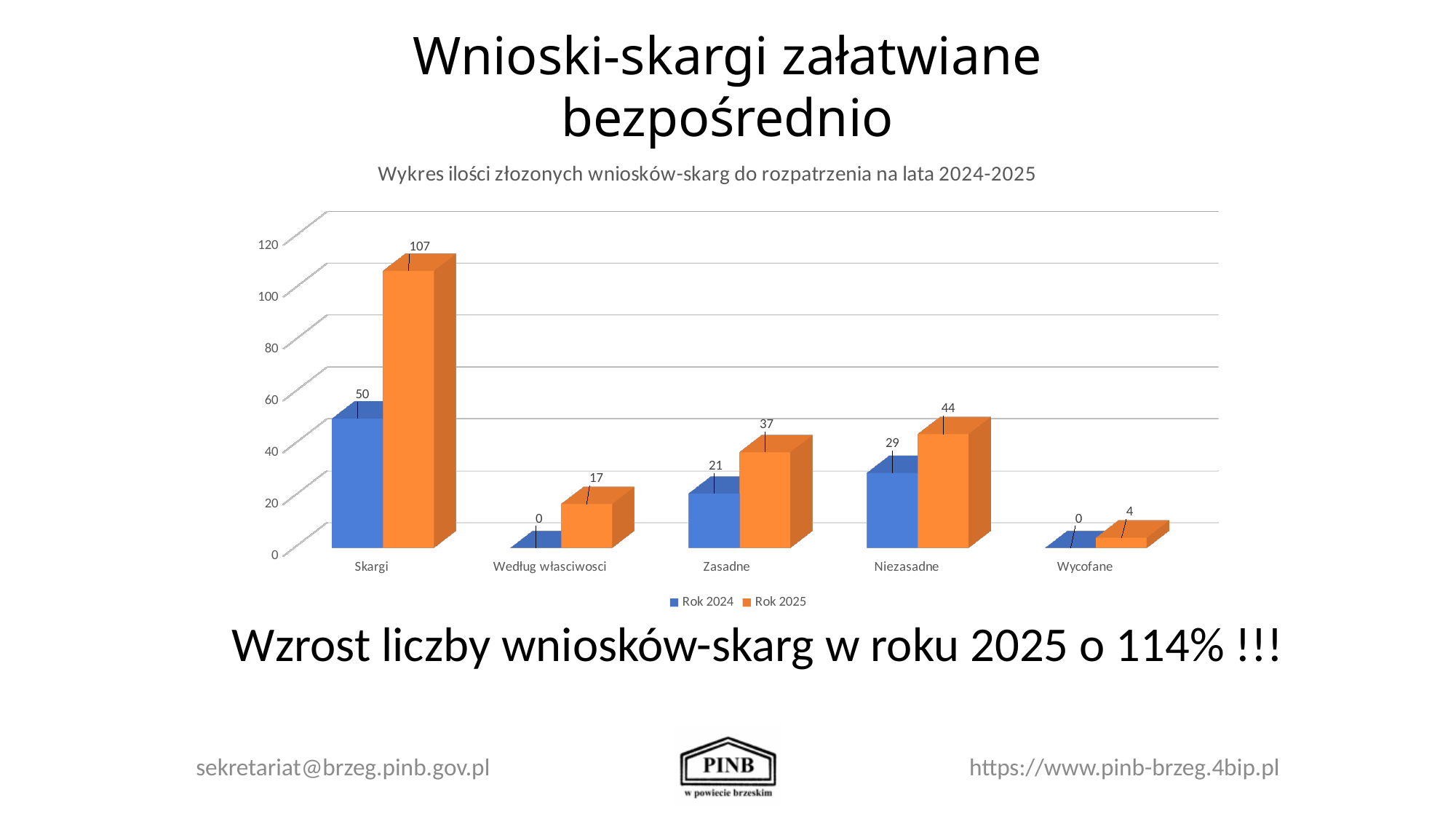
How many categories are shown on the x axis? 5 How many series does the legend list? 2 What is the value for Skargi in the Rok 2025 series? 107 What is the value for Niezasadne in the Rok 2024 series? 29 Which category has the highest value in the Rok 2025 series? Skargi What kind of chart is shown on the slide? Bar chart Which is larger for Zasadne: the Rok 2024 value or the Rok 2025 value? Rok 2025 What is the title of the chart? Wykres ilości złozonych wniosków-skarg do rozpatrzenia na lata 2024-2025 Which category has the lowest value in the Rok 2025 series? Wycofane What is the value for Wycofane in the Rok 2024 series? 0 What is the difference between the Rok 2025 and Rok 2024 values for Skargi? 57 What is the value for Według właściwości in the Rok 2025 series? 17